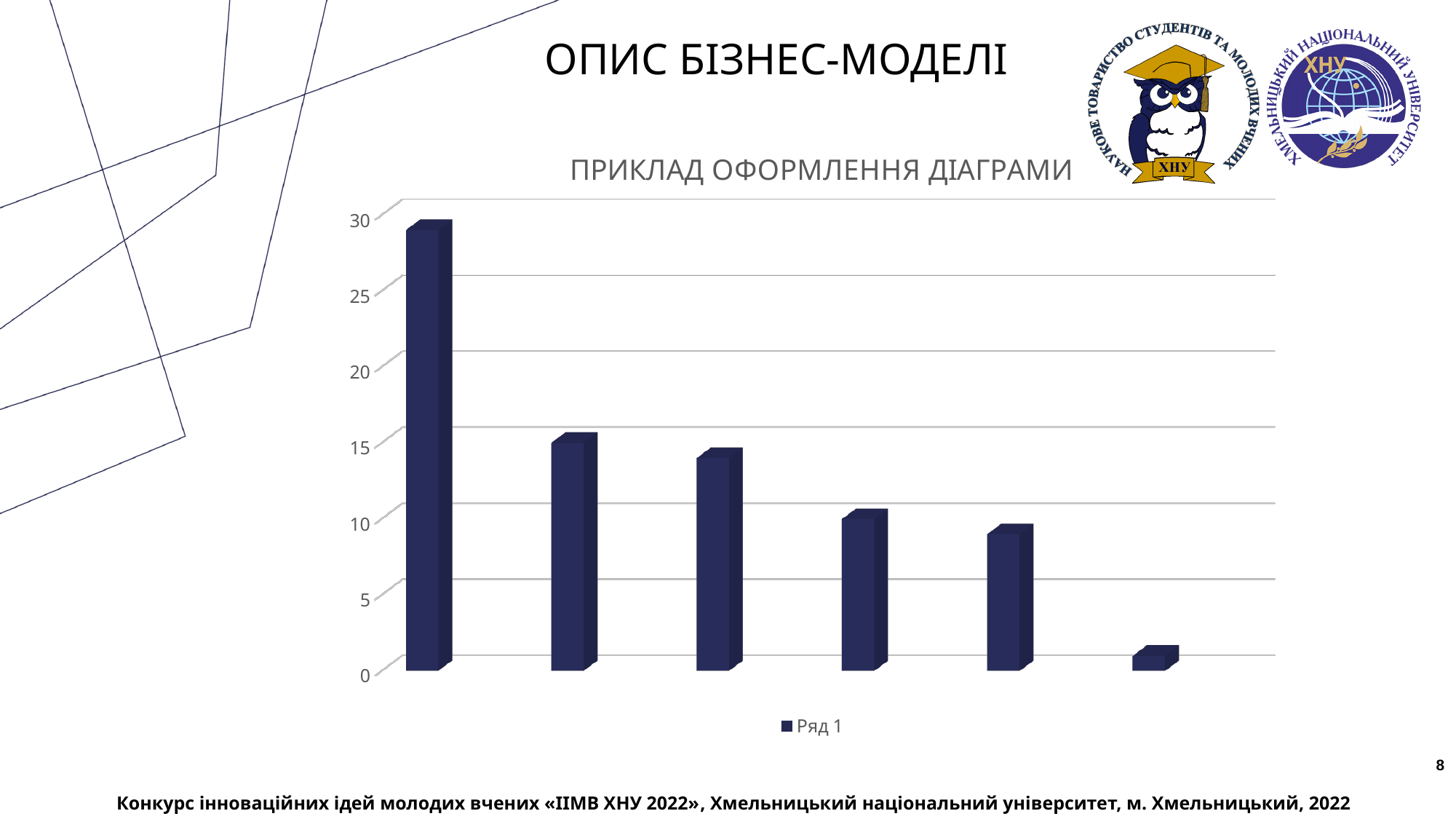
What kind of chart is shown on the slide? bar chart Which bar is the tallest in the chart? the first (leftmost) bar Which bar is the shortest in the chart? the last (rightmost) bar What is the title of the chart? ПРИКЛАД ОФОРМЛЕННЯ ДІАГРАМИ Is the value of the last (rightmost) bar greater or less than 5? less What is the name of the series shown in the legend? Ряд 1 Is the value of the third bar from the left greater or less than 10? greater Do the bar values rise or fall from left to right along the x axis? fall How many bars are plotted in the chart? 6 Is the value of the first (leftmost) bar greater or less than 25? greater Which is larger, the first bar or the second bar? the first bar How many series does the chart legend list? 1